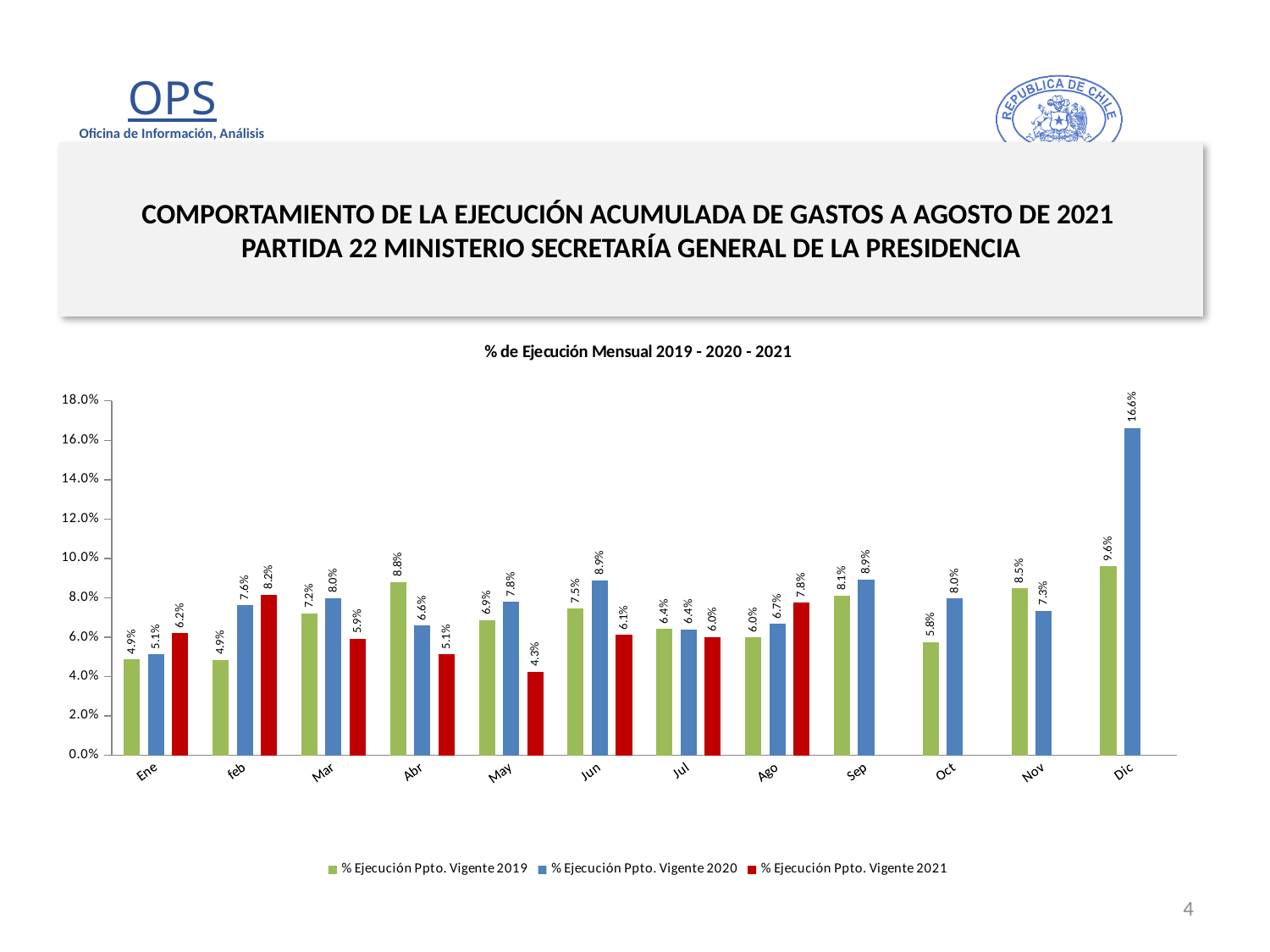
In Ago, which series has the larger value: % Ejecución Ppto. Vigente 2019 or % Ejecución Ppto. Vigente 2021? % Ejecución Ppto. Vigente 2021 How many series does the legend list? 3 Which month has the highest value for % Ejecución Ppto. Vigente 2020? Dic What is the value for % Ejecución Ppto. Vigente 2021 in Ene? 6.2% What kind of chart is shown on the slide? Bar chart Which month has the lowest value for % Ejecución Ppto. Vigente 2021? May What is the value for % Ejecución Ppto. Vigente 2020 in Dic? 16.6% How many months are shown on the x axis? 12 What is the value for % Ejecución Ppto. Vigente 2019 in Abr? 8.8% What is the difference between the 2020 and 2019 values in Dic? 7.0% Is the value for % Ejecución Ppto. Vigente 2020 in Dic greater or less than 14.0%? greater What is the title of the chart? % de Ejecución Mensual 2019 - 2020 - 2021